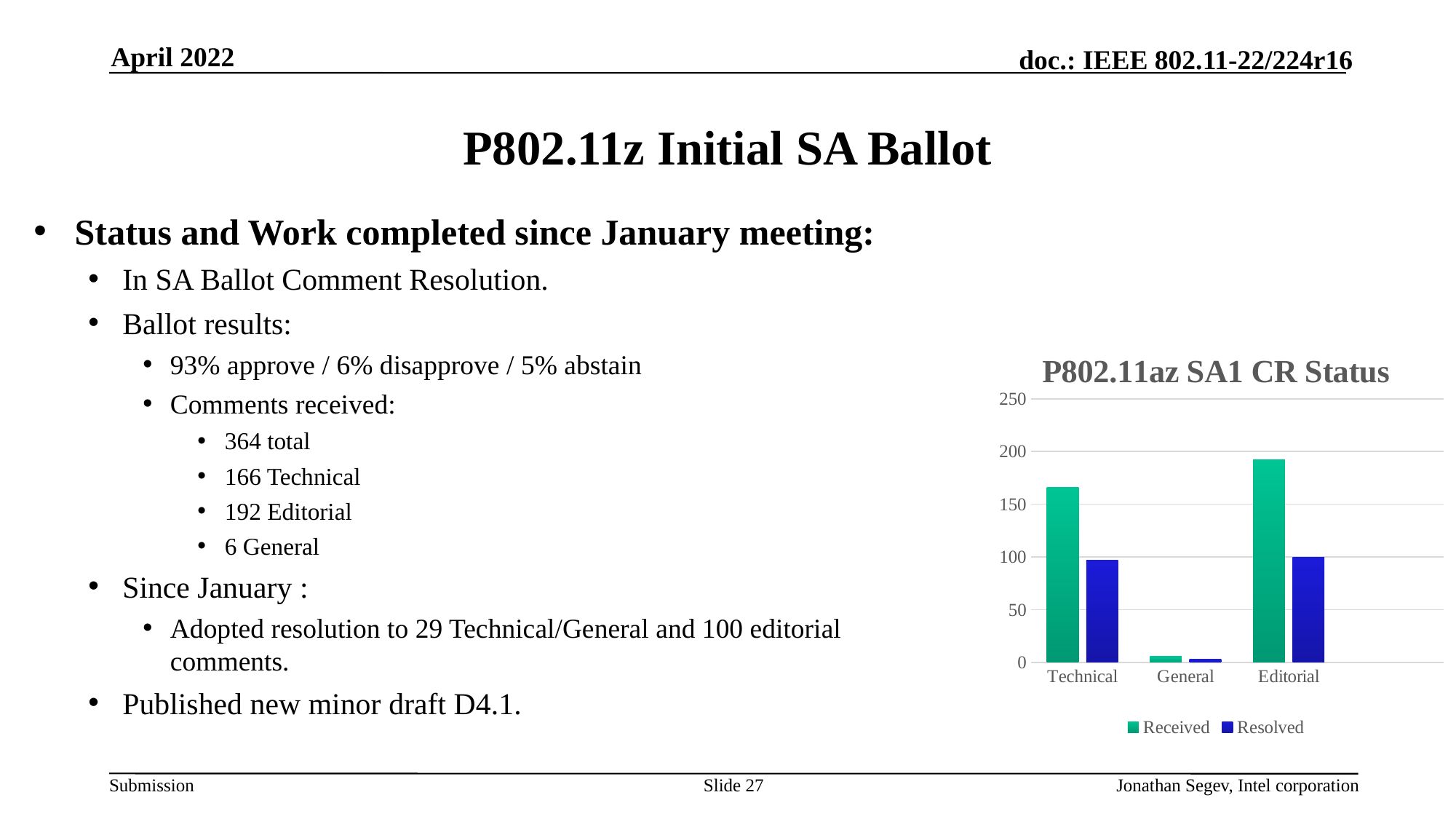
Which category has the lowest Received value? General How many series does the chart legend list? 2 What type of chart is shown on the slide? bar chart What is the title of the chart? P802.11az SA1 CR Status Which category has the highest Received value? Editorial For Editorial, which is larger: Received or Resolved? Received Is the Received value for Technical greater or less than 150? greater Is the Resolved value for Technical greater or less than 50? greater Which category has the lowest Resolved value? General Which series is shown in dark blue in the chart? Resolved Is the Received value for Editorial greater or less than 200? less How many categories are shown on the x axis of the chart? 3